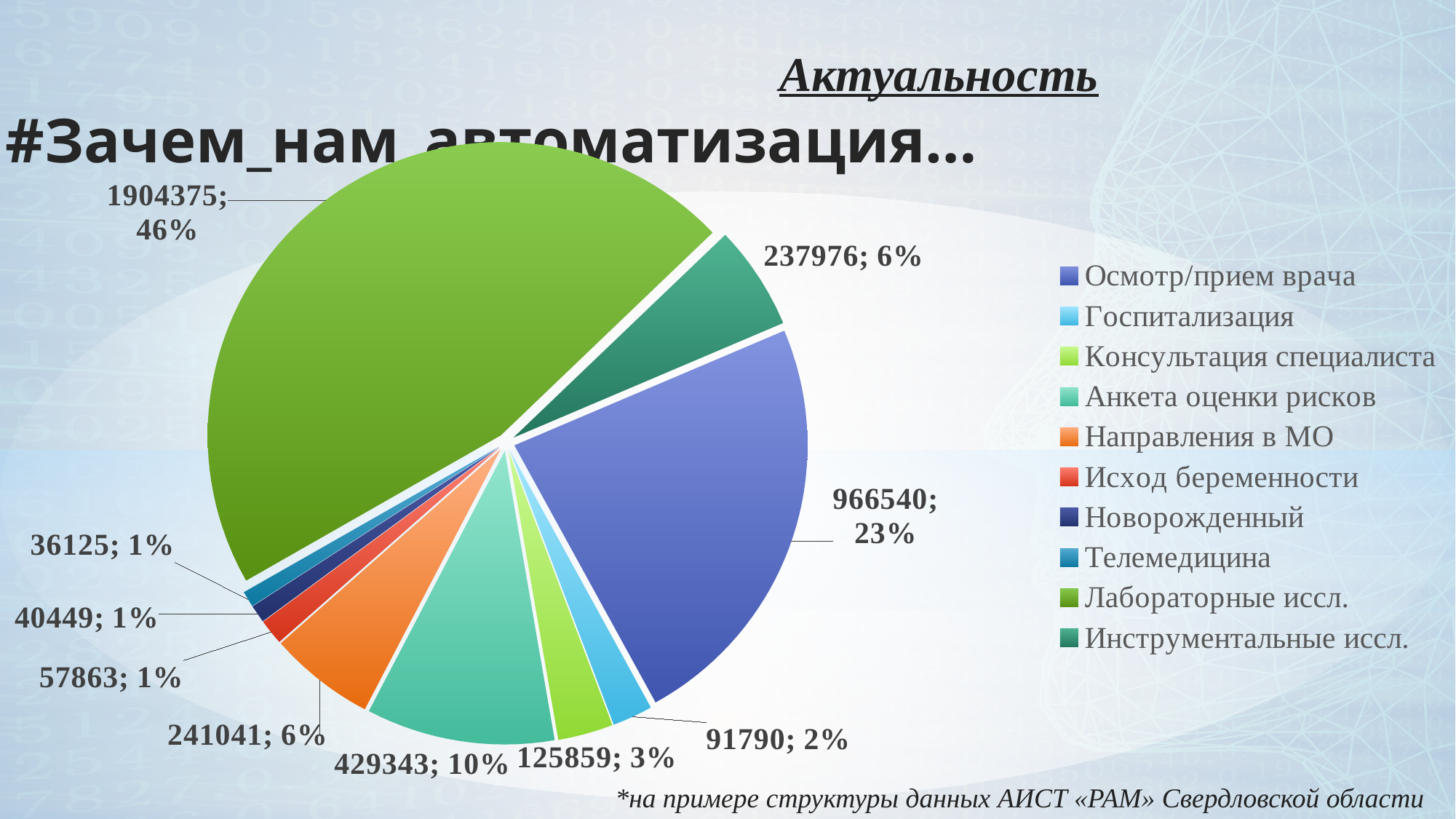
What value is shown for Анкета оценки рисков in the pie chart? 429343; 10% What colour is the slice for Направления в МО? orange What value is shown for Госпитализация in the pie chart? 91790; 2% What kind of chart is shown on the slide? pie chart Which category has the largest slice of the pie? Лабораторные иссл. What value is shown for Лабораторные иссл. in the pie chart? 1904375; 46% Which is larger: Направления в МО or Консультация специалиста? Направления в МО What share of the pie does Инструментальные иссл. take? 6% How many categories does the legend of the pie chart list? 10 What value is shown for Осмотр/прием врача in the pie chart? 966540; 23% What is the difference between the values for Анкета оценки рисков and Направления в МО? 188302 What is the difference between the values for Лабораторные иссл. and Осмотр/прием врача? 937835